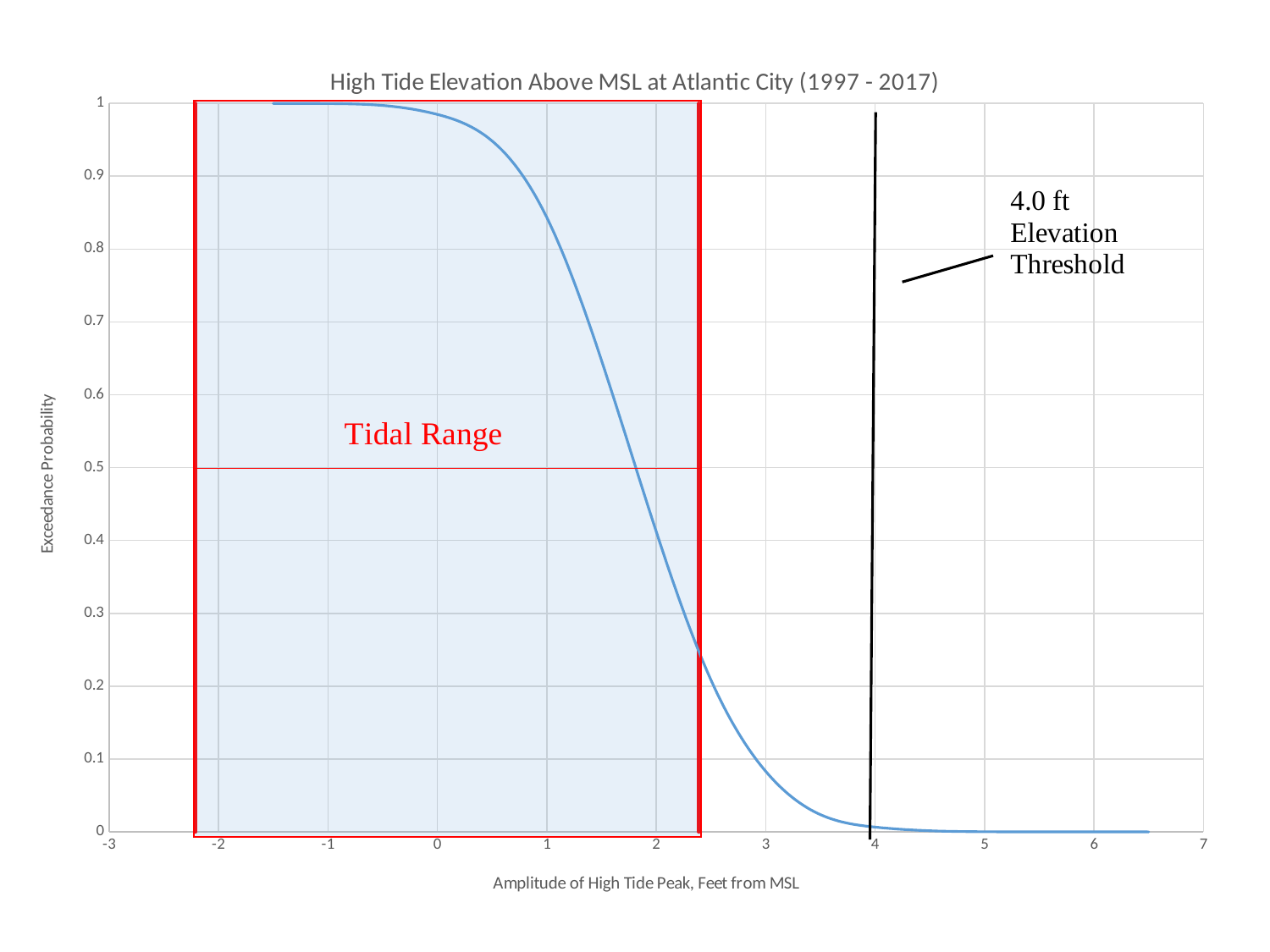
Is the exceedance probability at an amplitude of 3 feet greater or less than 0.2? less What is the title of the chart? High Tide Elevation Above MSL at Atlantic City (1997 - 2017) Is the exceedance probability at an amplitude of 1 foot greater or less than 0.7? greater Does the exceedance probability rise or fall as the amplitude of high tide peak increases? fall What kind of chart is shown on the slide? line chart What elevation threshold is marked by the vertical black line on the chart? 4.0 ft Is the exceedance probability at an amplitude of 0 feet greater or less than 0.9? greater